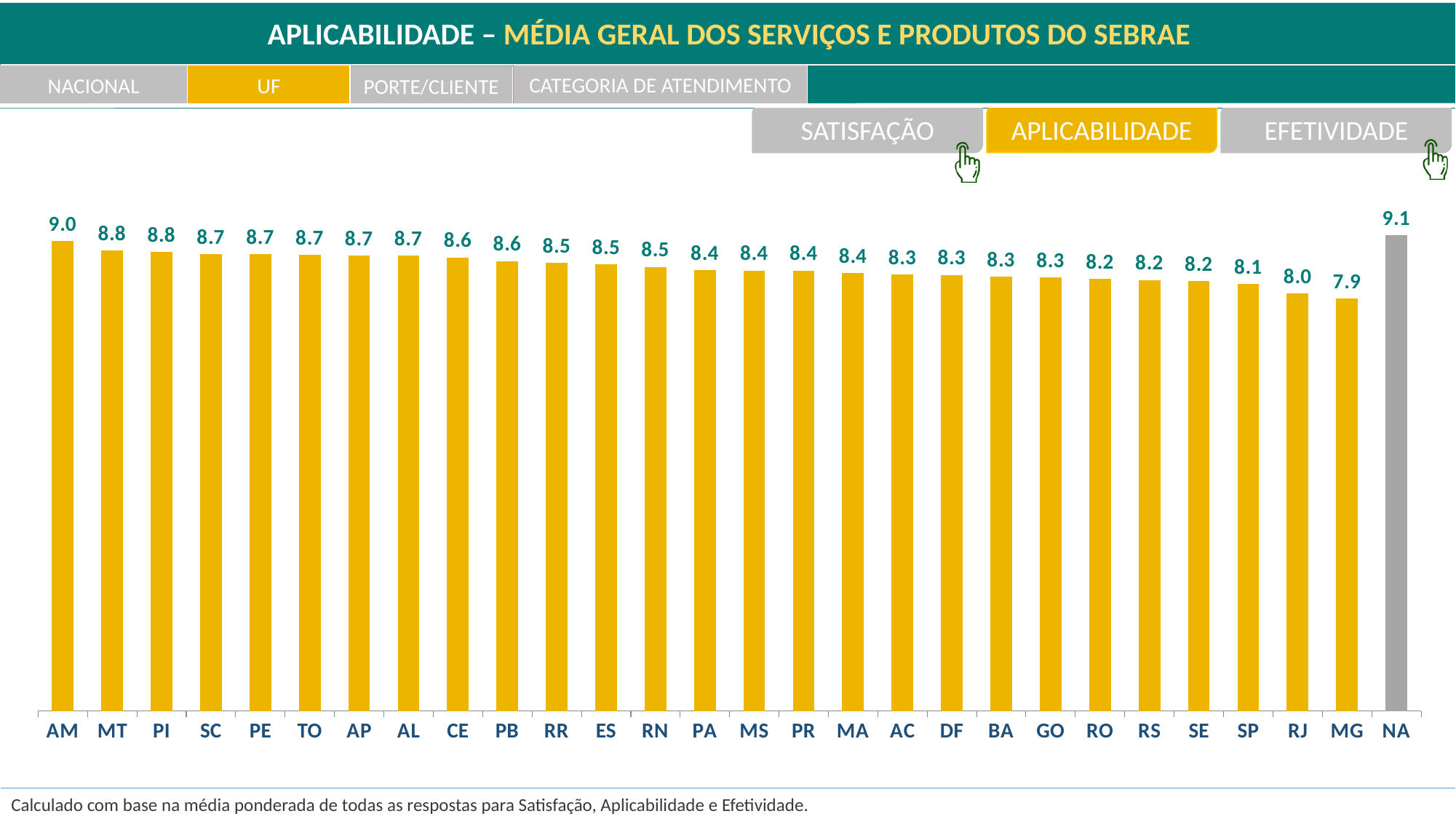
What is the difference between the values for AM and MG? 1.1 Which is larger, the value for CE or the value for RO? CE What is the difference between the values for NA and RJ? 1.1 What is the value for NA? 9.1 How many categories are shown on the x axis? 28 Which category has the highest value? NA Which category has the lowest value? MG What kind of chart is shown on the slide? bar chart What is the value for MG? 7.9 Which bar is shown in grey rather than yellow? NA What is the value for SP? 8.1 What is the value for AM? 9.0